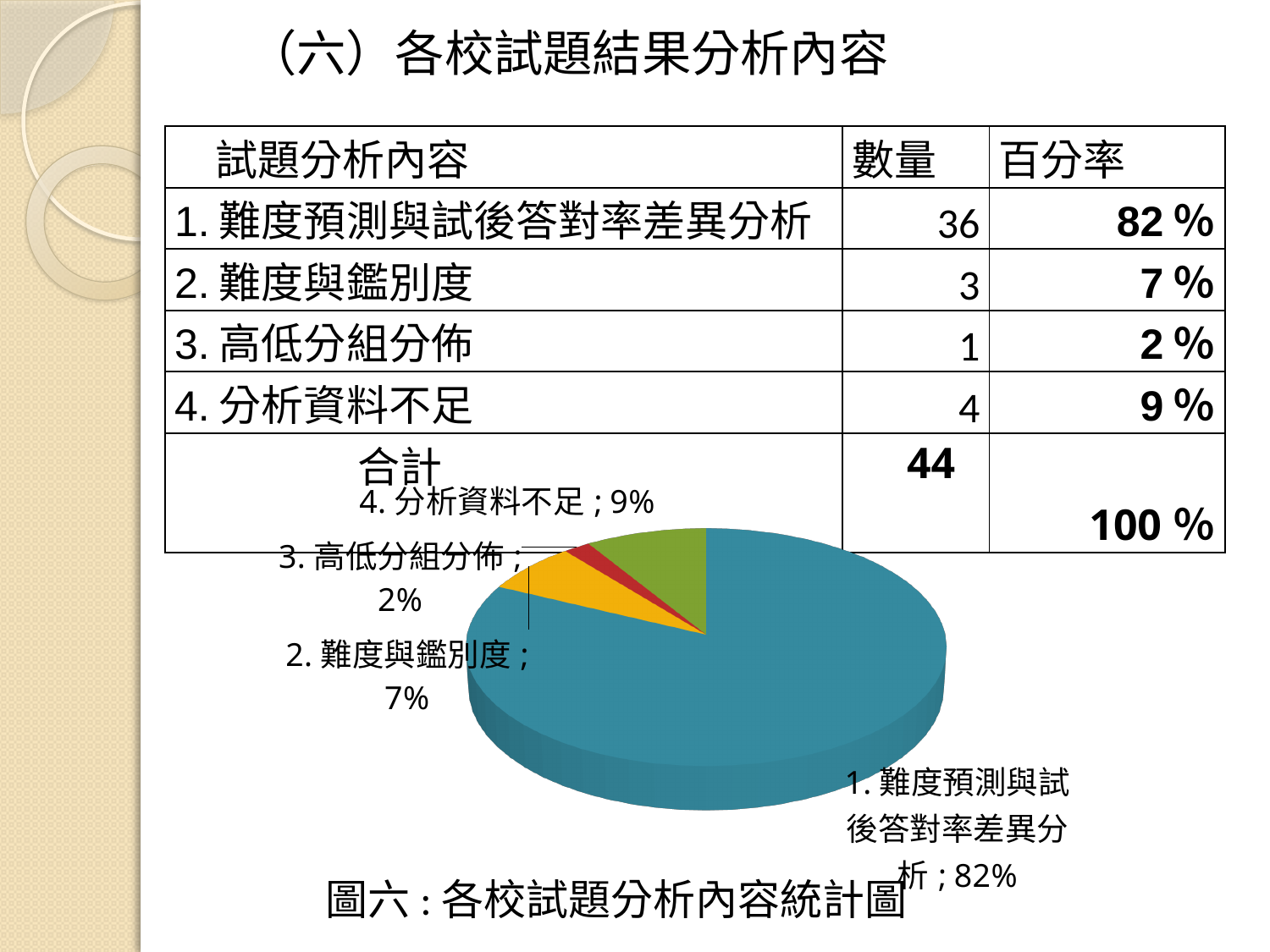
Which is larger in the pie chart: 「2. 難度與鑑別度」 or 「4. 分析資料不足」? 4. 分析資料不足 Which slice of the pie chart is the smallest? 3. 高低分組分佈 What percentage does the slice labelled 「1. 難度預測與試後答對率差異分析」 show? 82% How many slices does the pie chart have? 4 What percentage does the slice labelled 「3. 高低分組分佈」 show? 2% What percentage does the slice labelled 「2. 難度與鑑別度」 show? 7% What is the caption of the pie chart? 圖六：各校試題分析內容統計圖 What percentage does the slice labelled 「4. 分析資料不足」 show? 9% What colour is the largest slice of the pie chart? teal blue What kind of chart is shown on the slide? pie chart What is the difference in percentage points between 「4. 分析資料不足」 and 「2. 難度與鑑別度」? 2 Which slice of the pie chart is the largest? 1. 難度預測與試後答對率差異分析